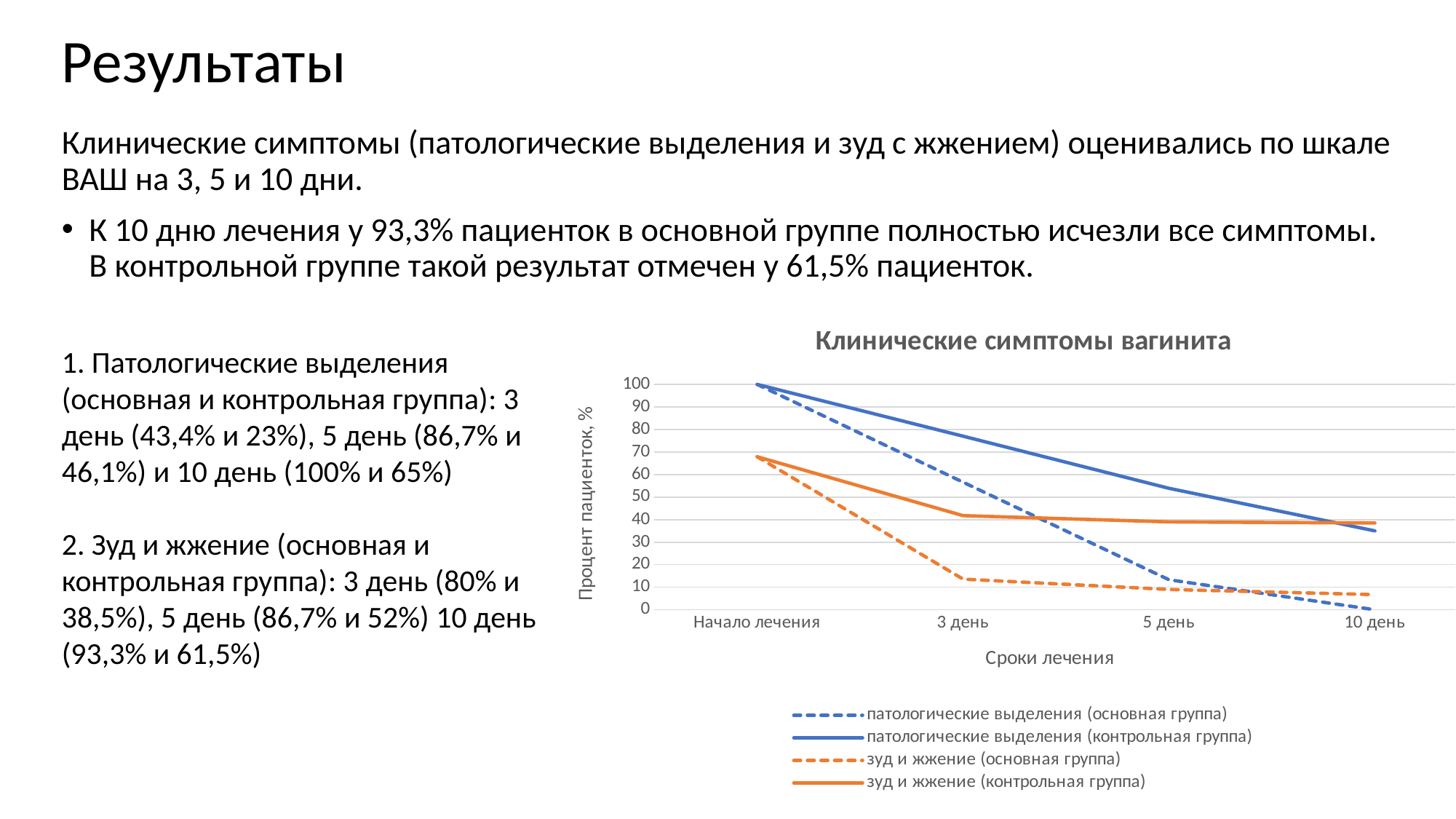
Which series has the highest value at 3 день? патологические выделения (контрольная группа) Is the value for патологические выделения (контрольная группа) at 5 день greater or less than 50? greater Do the values for патологические выделения (основная группа) rise or fall from Начало лечения to 10 день? fall Is the value for зуд и жжение (основная группа) at 3 день greater or less than 20? less Is the value for зуд и жжение (контрольная группа) at Начало лечения greater or less than 60? greater Which series has the lowest value at 10 день? патологические выделения (основная группа) What kind of chart is shown on the slide? line chart What is the title of the chart? Клинические симптомы вагинита How many time points are shown on the x axis of the chart? 4 How many series does the legend of the chart list? 4 At 5 день, which is larger: патологические выделения (основная группа) or зуд и жжение (основная группа)? патологические выделения (основная группа) What is the value for патологические выделения (контрольная группа) at Начало лечения? 100